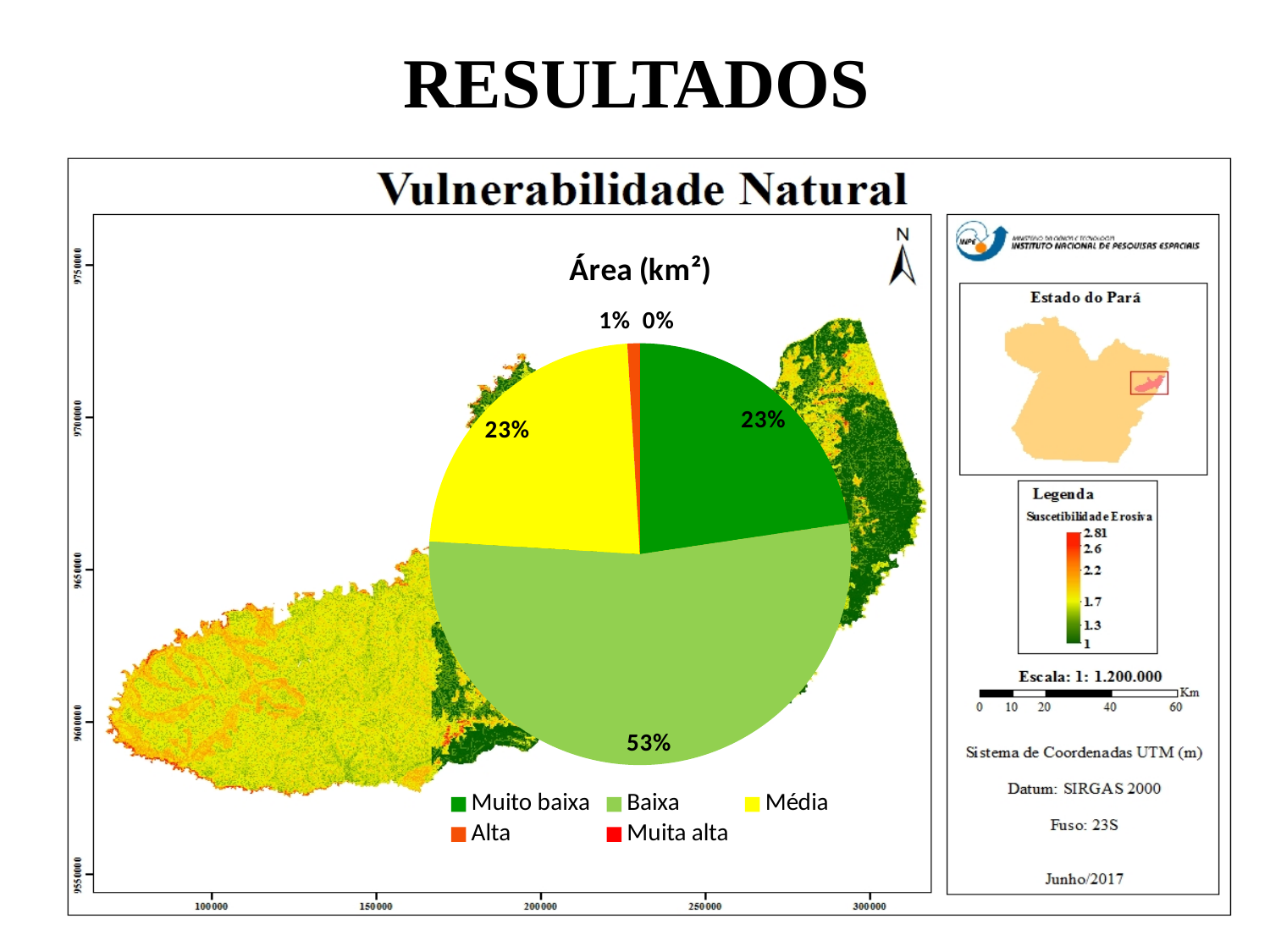
What is the value shown for Alta in the pie chart? 1% Which is larger in the pie chart, the Baixa slice or the Alta slice? Baixa What type of chart is shown on the slide? pie chart How many categories does the pie chart legend list? 5 Which category has the largest slice of the pie chart? Baixa What is the title of the pie chart? Área (km²) Which category has the smallest slice of the pie chart? Muita alta What is the value shown for Muito baixa in the pie chart? 23% What is the value shown for Média in the pie chart? 23% What is the value shown for Muita alta in the pie chart? 0% What is the difference in percentage points between the Baixa slice and the Média slice? 30 percentage points What share of the pie does the Baixa slice represent? 53%